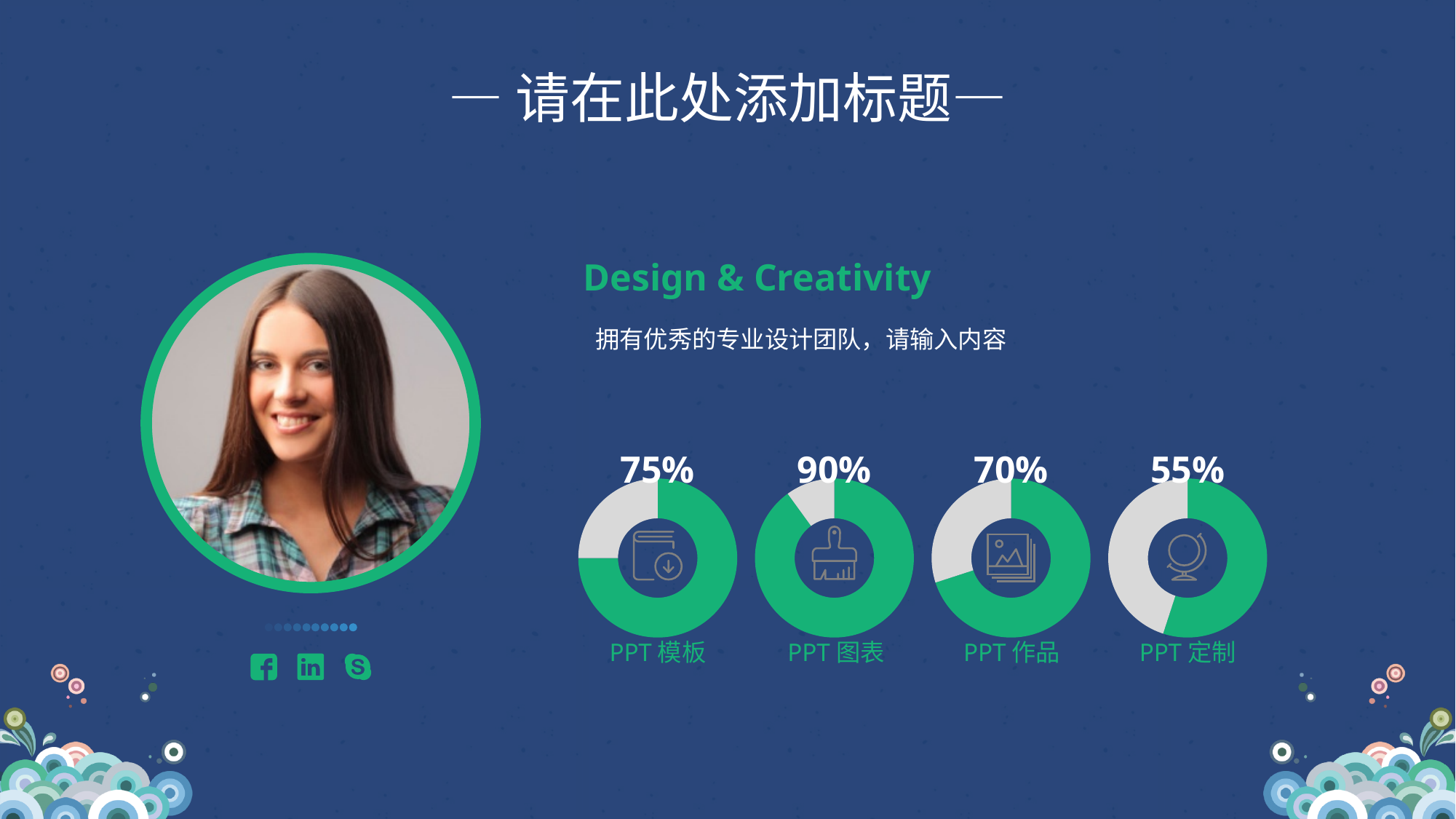
Which of the four donut charts shows the lowest percentage? PPT 定制 What percentage is shown on the donut chart labelled PPT 模板? 75% What is the difference between the percentages shown for PPT 模板 and PPT 作品? 5% What is the difference between the percentages shown for PPT 图表 and PPT 定制? 35% What percentage is shown on the donut chart labelled PPT 图表? 90% What kind of chart is used to display the four percentages on the slide? Donut chart What percentage is shown on the donut chart labelled PPT 作品? 70% Which shows a larger percentage, the PPT 模板 chart or the PPT 作品 chart? PPT 模板 How many donut charts are shown on the slide? 4 What colour is the filled portion of each donut chart? Green What percentage is shown on the donut chart labelled PPT 定制? 55% Which of the four donut charts shows the highest percentage? PPT 图表